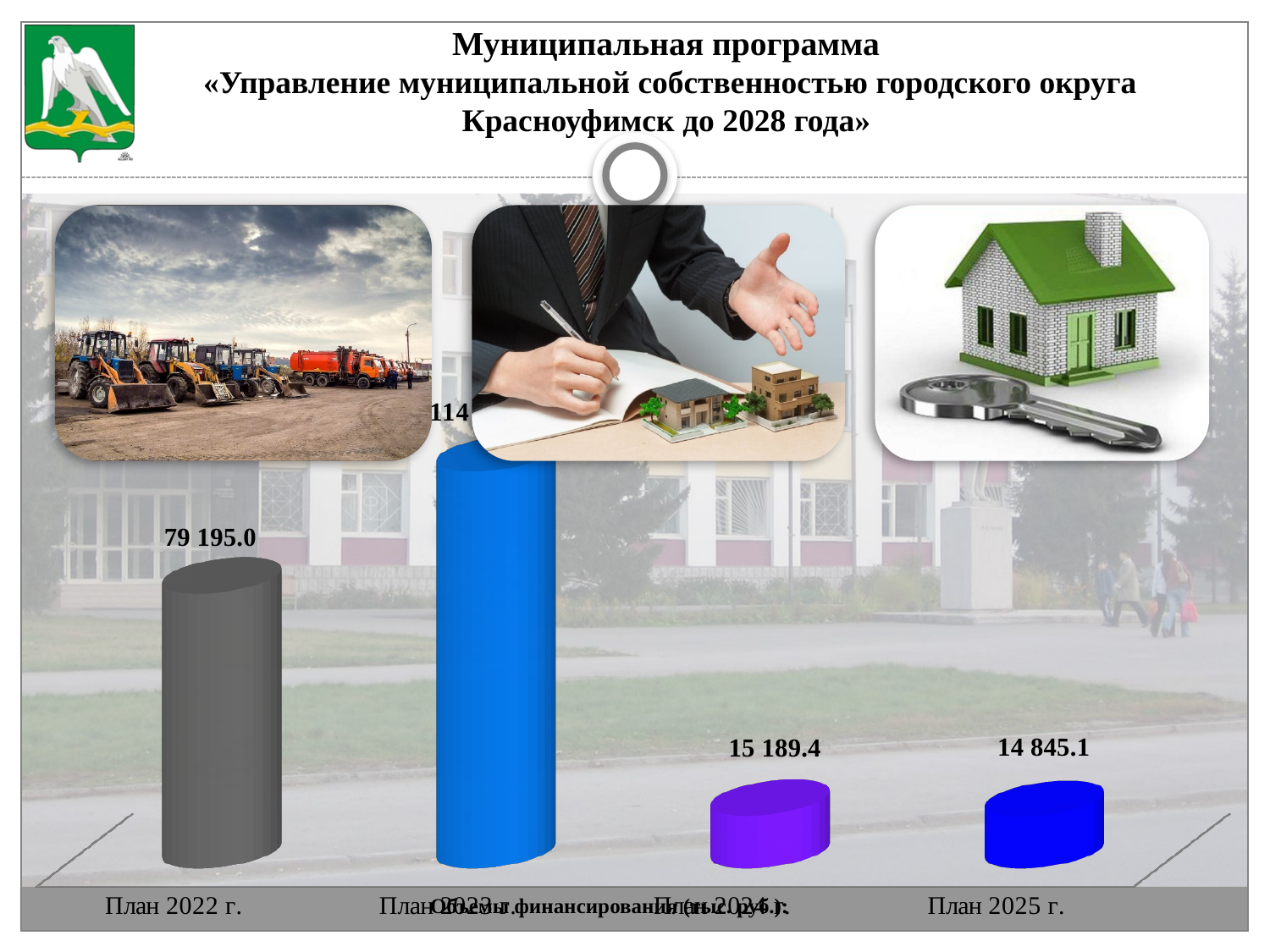
Which category has the highest value? План 2023 г. How many categories are shown in the chart? 4 Which category has the lowest value? План 2025 г. Which is larger, the value for План 2022 г. or the value for План 2024 г.? План 2022 г. What kind of chart is shown on the slide? Bar chart Does the value rise or fall from План 2024 г. to План 2025 г.? Falls What is the difference between the values for План 2024 г. and План 2025 г.? 344.3 What is the value for План 2024 г.? 15 189.4 What colour is the bar for План 2022 г.? Grey What is the value for План 2025 г.? 14 845.1 What is the value for План 2022 г.? 79 195.0 What is the difference between the values for План 2022 г. and План 2024 г.? 64 005.6